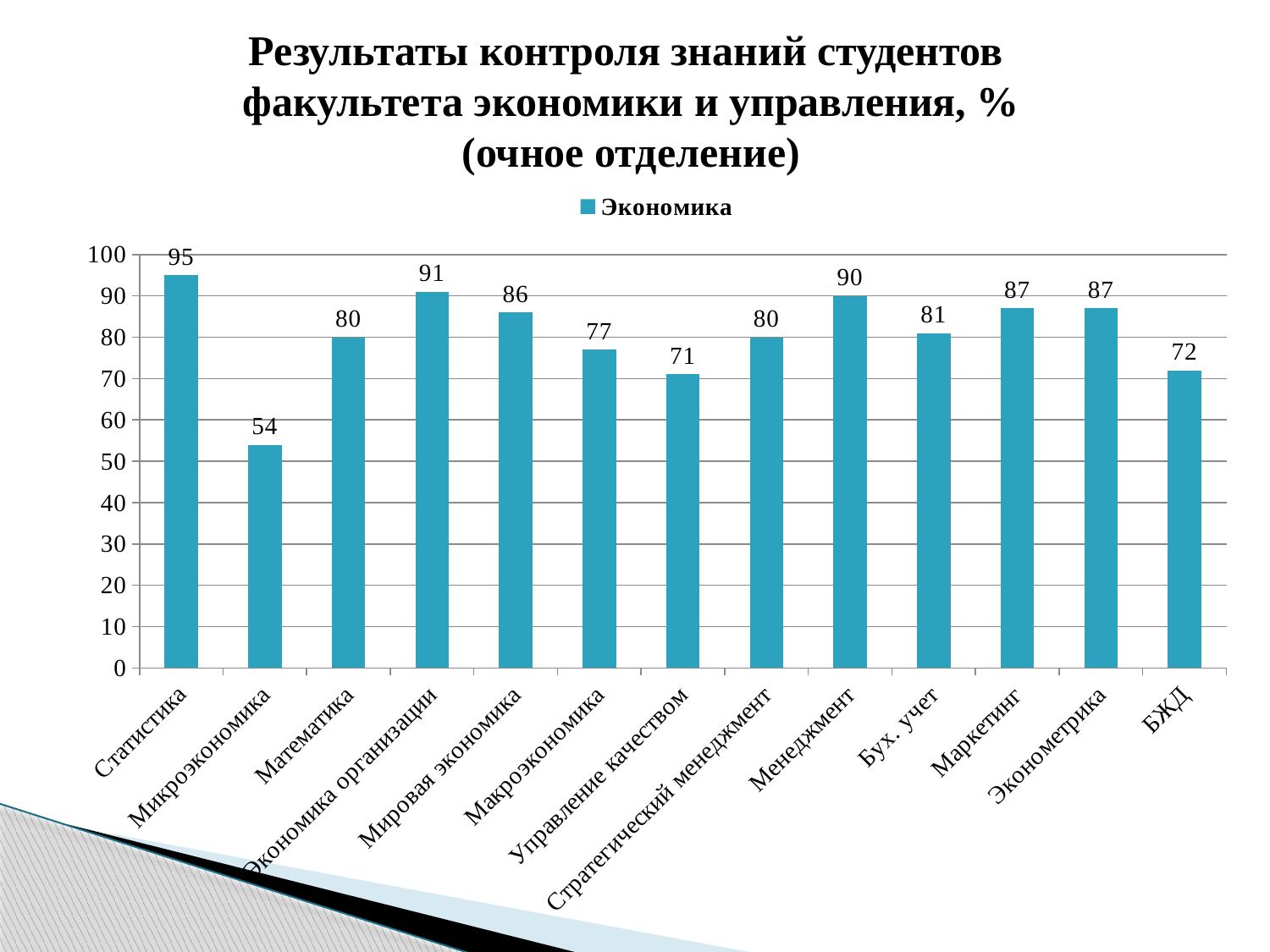
What is the value for БЖД? 72 How many categories are shown on the x axis? 13 Which is larger, the value for Мировая экономика or the value for Макроэкономика? Мировая экономика What is the value for Бух. учет? 81 Which category has the lowest value? Микроэкономика What is the difference between the values for Статистика and Микроэкономика? 41 What is the value for Статистика? 95 How many series does the legend list? 1 Which category has the highest value? Статистика What kind of chart is shown on the slide? Bar chart What series name is shown in the legend? Экономика What is the value for Микроэкономика? 54